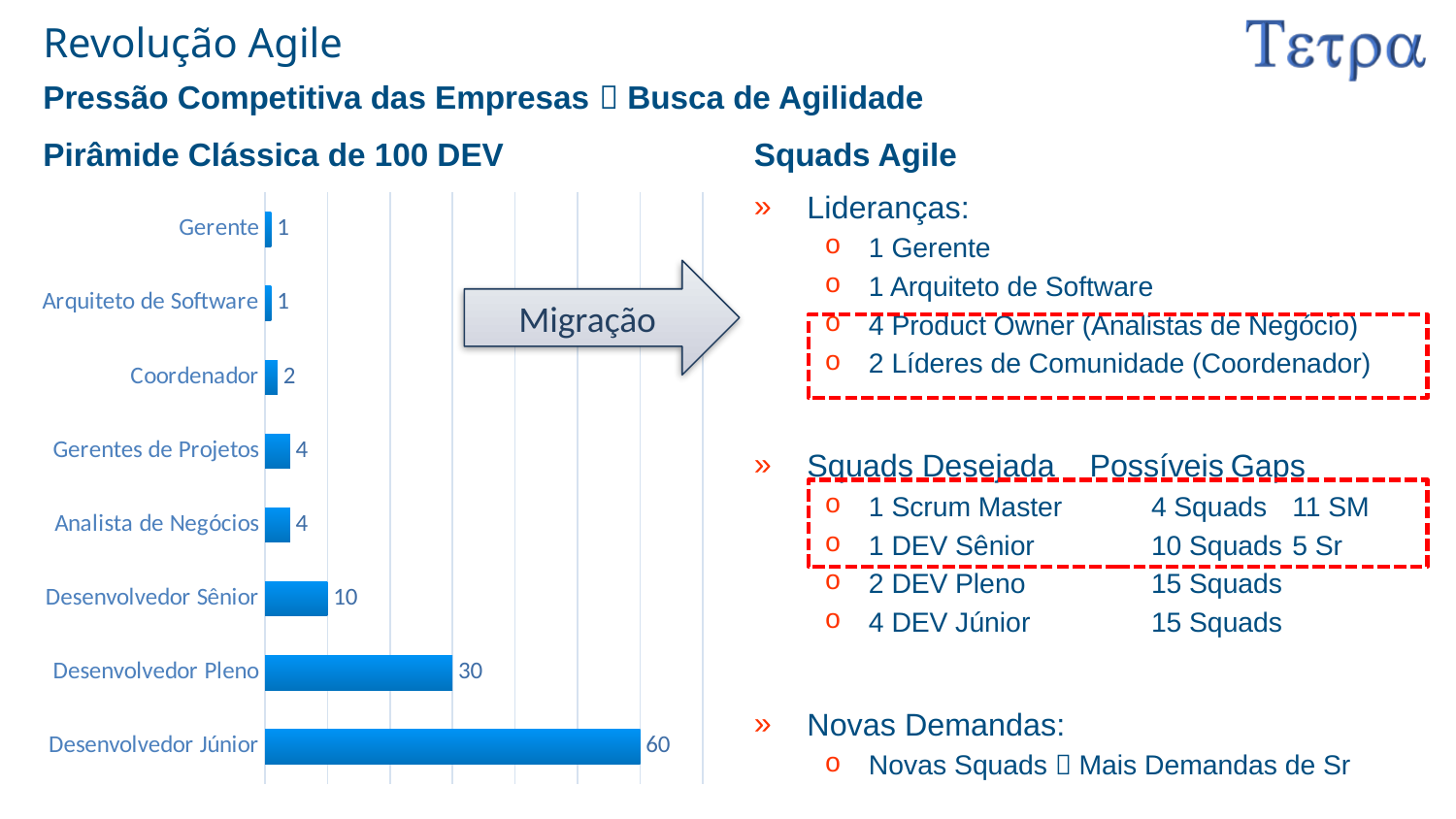
What kind of chart is shown on the slide? Bar chart What is the value for Coordenador in the bar chart? 2 Which is larger, the value for Desenvolvedor Pleno or the value for Desenvolvedor Sênior? Desenvolvedor Pleno What is the title of the bar chart on the slide? Pirâmide Clássica de 100 DEV What is the difference between the values for Desenvolvedor Sênior and Gerentes de Projetos? 6 What is the value for Desenvolvedor Sênior in the bar chart? 10 What is the value for Desenvolvedor Pleno in the bar chart? 30 What is the total of the values for Gerentes de Projetos and Analista de Negócios? 8 How many categories are shown in the bar chart? 8 What is the difference between the values for Desenvolvedor Júnior and Desenvolvedor Pleno? 30 What is the value for Desenvolvedor Júnior in the bar chart? 60 Which category has the highest value in the bar chart? Desenvolvedor Júnior